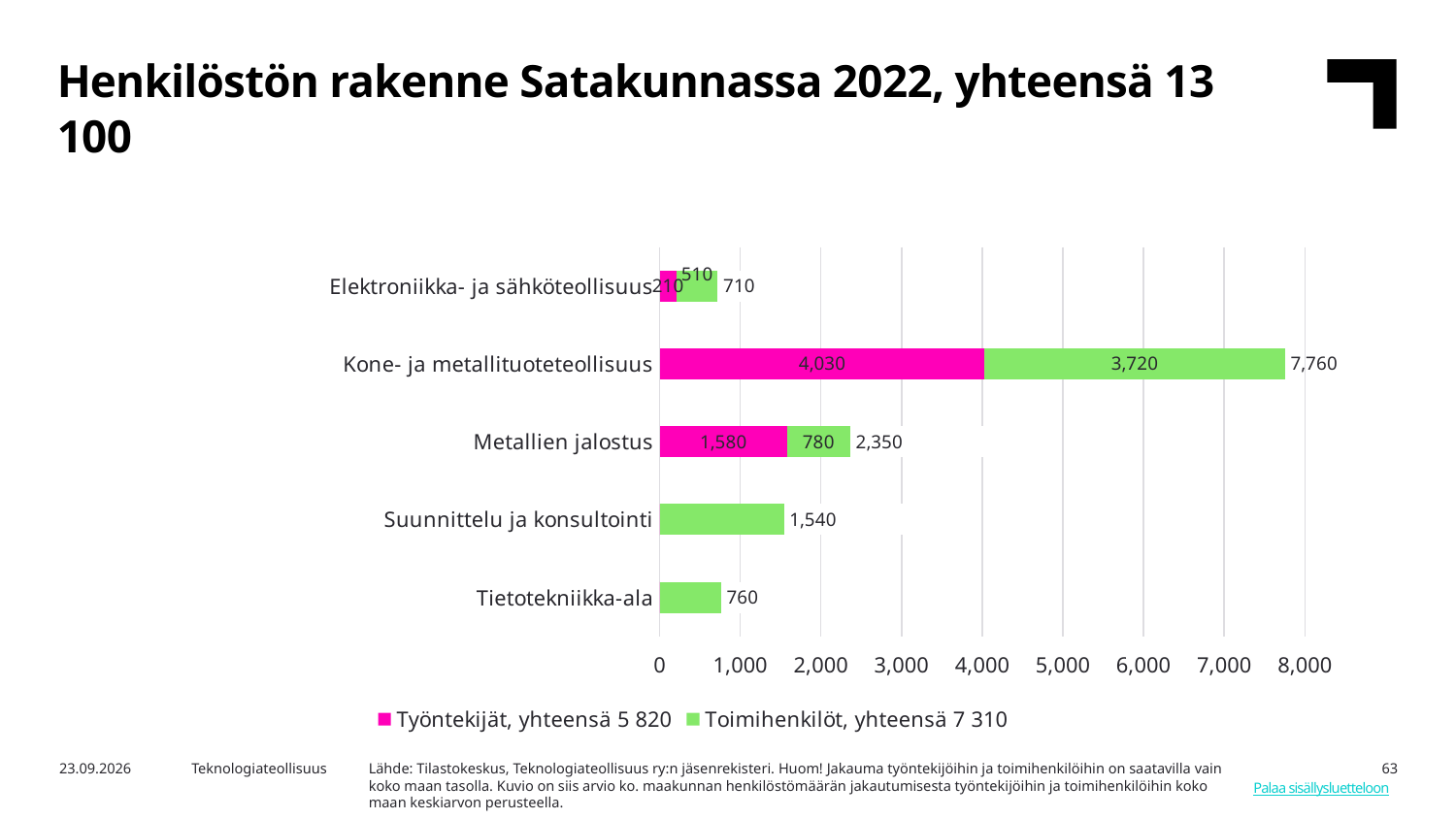
How many categories are shown on the chart? 5 What is the Työntekijät value for Kone- ja metallituoteteollisuus? 4,030 What is the Toimihenkilöt value for Metallien jalostus? 780 Which category has the lowest total? Elektroniikka- ja sähköteollisuus What type of chart is shown on the slide? Stacked bar chart What is the difference between the Työntekijät and Toimihenkilöt values for Metallien jalostus? 800 How many series does the legend list? 2 Which category has the highest total? Kone- ja metallituoteteollisuus Which is larger for Kone- ja metallituoteteollisuus: the Työntekijät value or the Toimihenkilöt value? Työntekijät What total is given for Toimihenkilöt in the legend? 7 310 What is the total of the stacked bar for Elektroniikka- ja sähköteollisuus? 710 What is the total shown for Suunnittelu ja konsultointi? 1,540